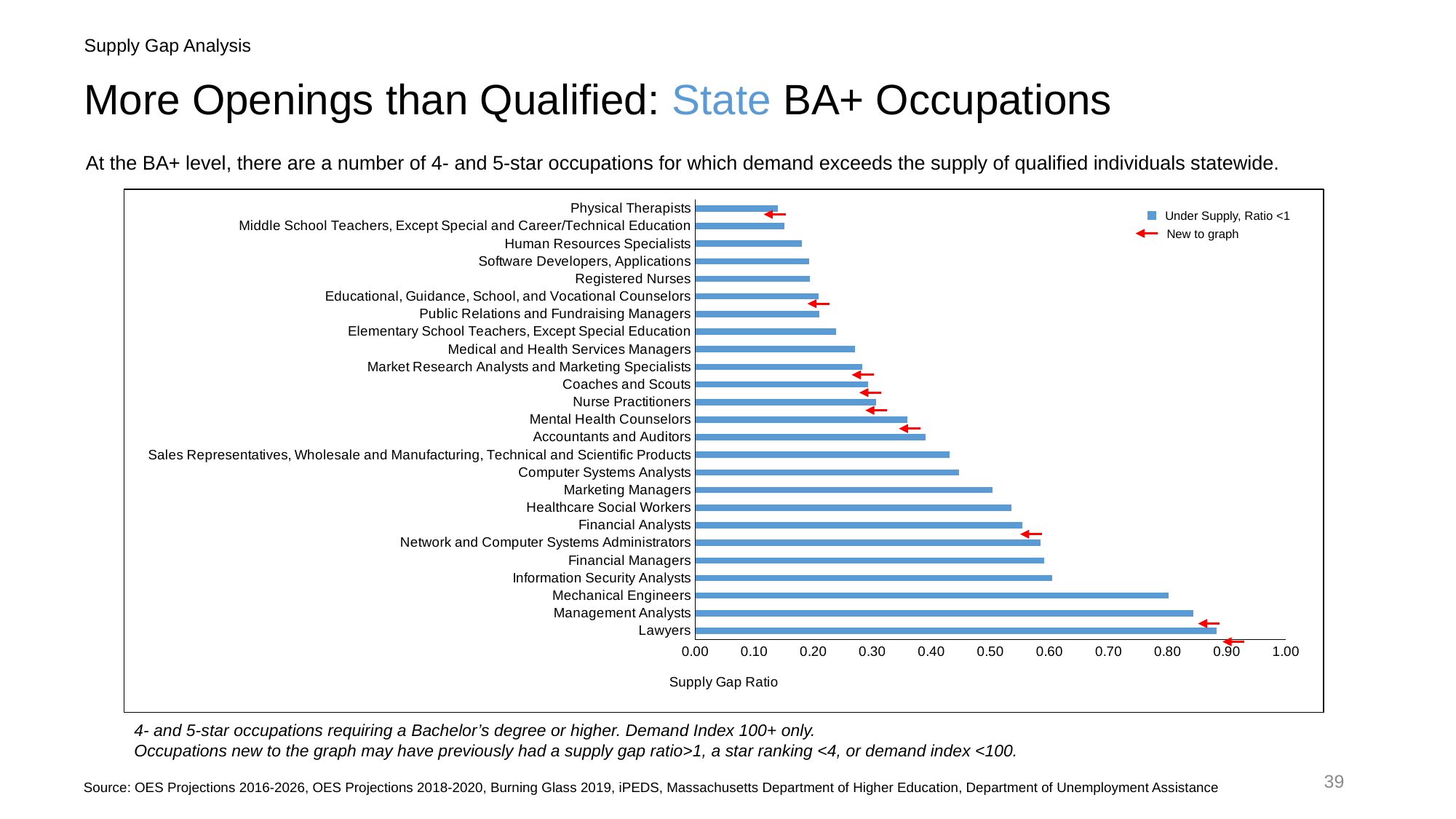
Which has a larger supply gap ratio, Physical Therapists or Accountants and Auditors? Accountants and Auditors Is the supply gap ratio for Healthcare Social Workers greater or less than 0.50? greater What is the label of the horizontal axis of the chart? Supply Gap Ratio How many occupations are plotted in the chart? 25 What kind of chart is shown on the slide? Bar chart Is the supply gap ratio for Mental Health Counselors greater or less than 0.30? greater Which has a larger supply gap ratio, Mechanical Engineers or Marketing Managers? Mechanical Engineers Which occupation has the highest supply gap ratio in the chart? Lawyers Is the supply gap ratio for Human Resources Specialists greater or less than 0.20? less What does the red arrow symbol in the legend indicate? New to graph